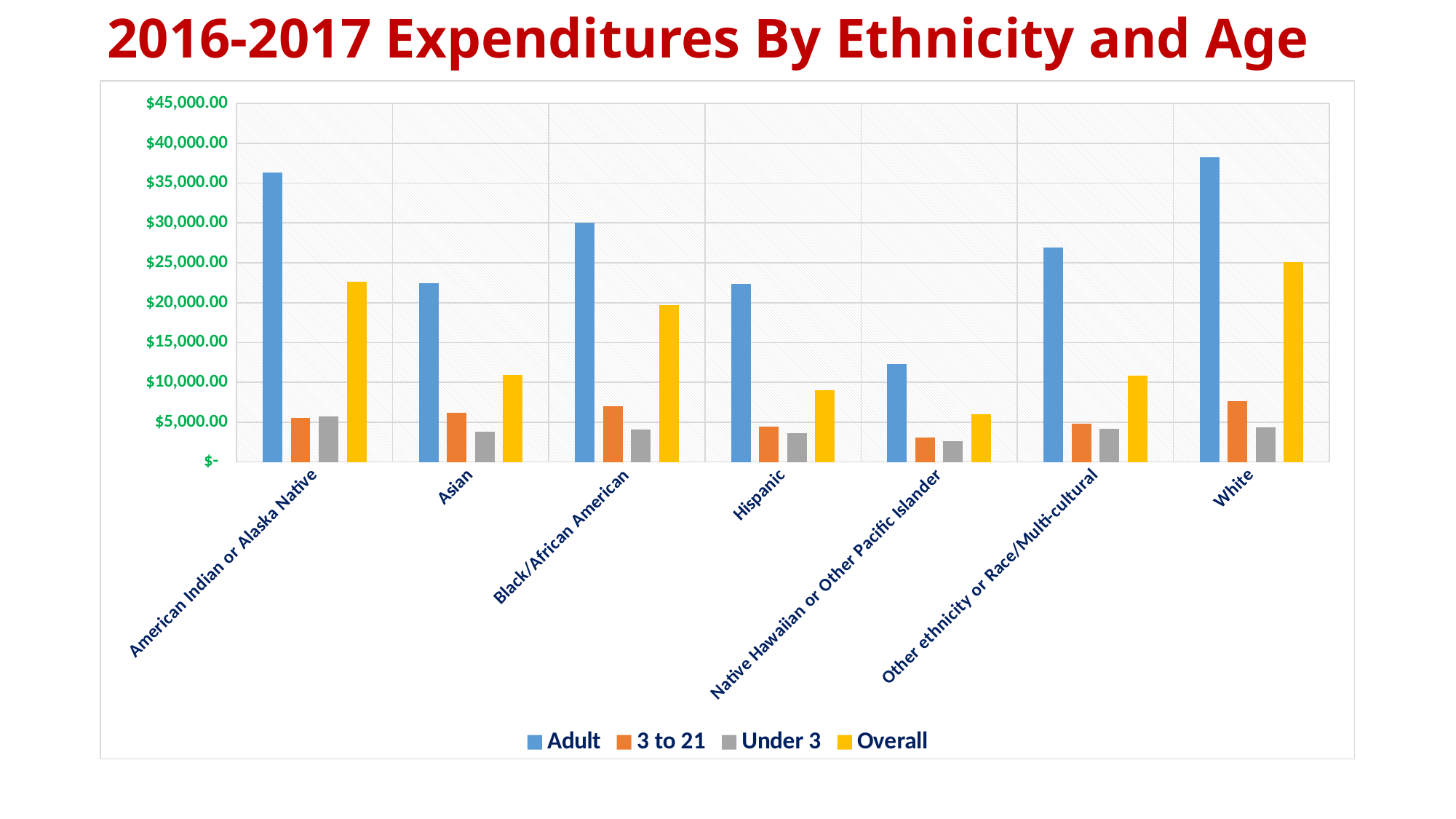
How many ethnicity categories are shown on the x axis? 7 What kind of chart is shown on the slide? bar chart How many series does the legend list? 4 Which ethnicity category has the highest Overall expenditure? White Which ethnicity category has the lowest Adult expenditure? Native Hawaiian or Other Pacific Islander Is the Adult value for American Indian or Alaska Native greater or less than $35,000.00? greater Which ethnicity category has the lowest Overall expenditure? Native Hawaiian or Other Pacific Islander Is the Overall value for Hispanic greater or less than $10,000.00? less Which is larger, the Adult value for Black/African American or the Adult value for Other ethnicity or Race/Multi-cultural? Black/African American Is the Adult value for Native Hawaiian or Other Pacific Islander greater or less than $10,000.00? greater Which ethnicity category has the highest Adult expenditure? White What is the title of the chart? 2016-2017 Expenditures By Ethnicity and Age